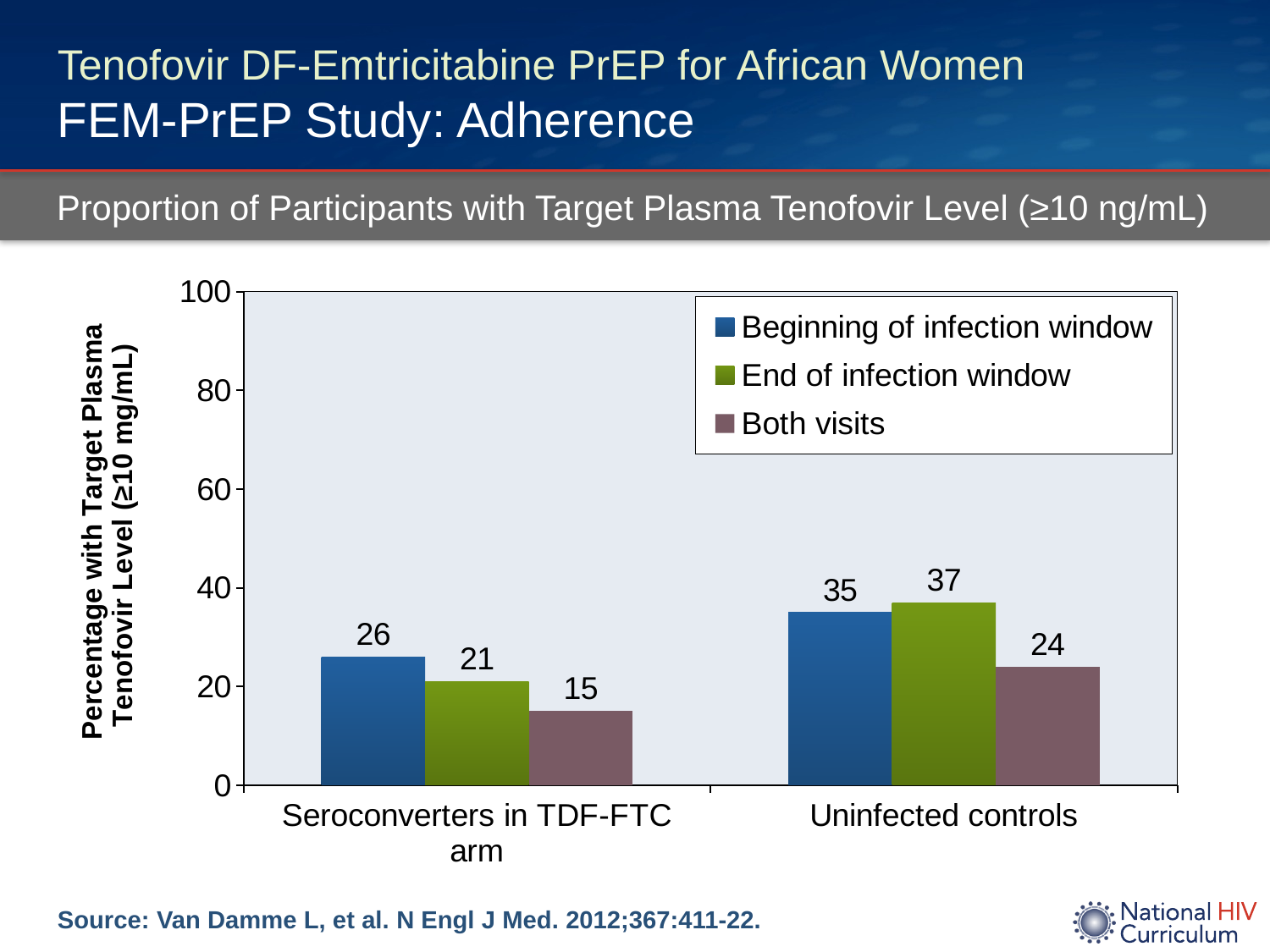
How many series does the legend list? 3 Which series has the highest value for Uninfected controls? End of infection window What kind of chart is shown on the slide? bar chart Which series has the lowest value for Seroconverters in TDF-FTC arm? Both visits Which is larger: the 'End of infection window' value for Seroconverters in TDF-FTC arm or for Uninfected controls? Uninfected controls What is the value for 'Both visits' for Seroconverters in TDF-FTC arm? 15 How many categories are shown on the x axis? 2 What is the value for 'End of infection window' for Uninfected controls? 37 Is the 'Beginning of infection window' value for Uninfected controls greater or less than 40? less What is the value for 'Beginning of infection window' for Seroconverters in TDF-FTC arm? 26 What is the difference between the 'Beginning of infection window' values for Uninfected controls and Seroconverters in TDF-FTC arm? 9 What is the value for 'Both visits' for Uninfected controls? 24